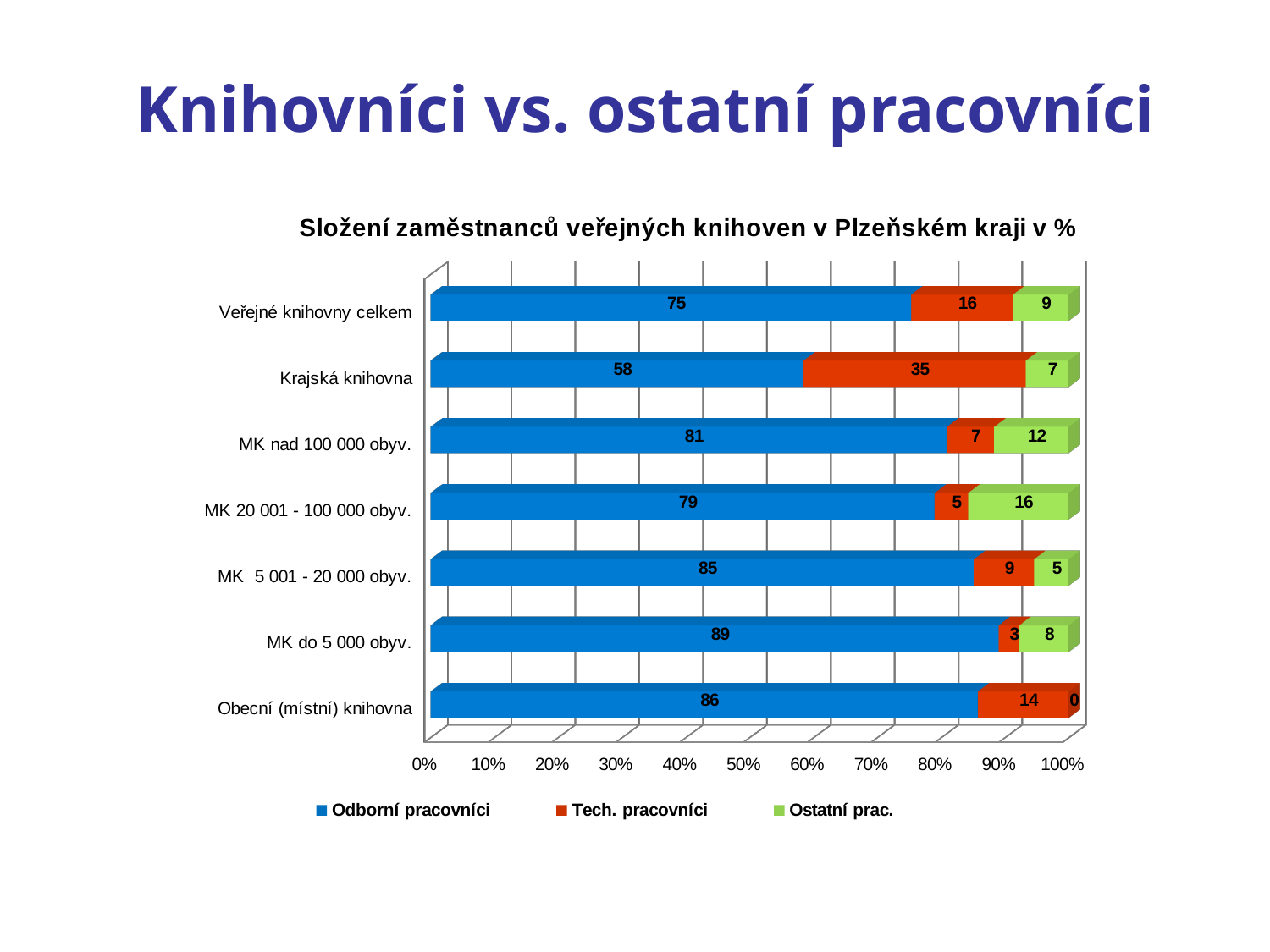
How many series does the legend list? 3 Which is larger: the Ostatní prac. value for MK nad 100 000 obyv. or for MK 5 001 - 20 000 obyv.? MK nad 100 000 obyv. How many categories are shown on the chart? 7 What is the value for Ostatní prac. for MK 20 001 - 100 000 obyv.? 16 What is the title of the chart? Složení zaměstnanců veřejných knihoven v Plzeňském kraji v % Which category has the lowest value for Odborní pracovníci? Krajská knihovna What kind of chart is shown on the slide? Stacked bar chart What is the value for Odborní pracovníci for Krajská knihovna? 58 What is the difference between the Odborní pracovníci values for MK do 5 000 obyv. and Krajská knihovna? 31 What is the value for Tech. pracovníci for Veřejné knihovny celkem? 16 Which category has the highest value for Odborní pracovníci? MK do 5 000 obyv. Which category has the highest value for Tech. pracovníci? Krajská knihovna